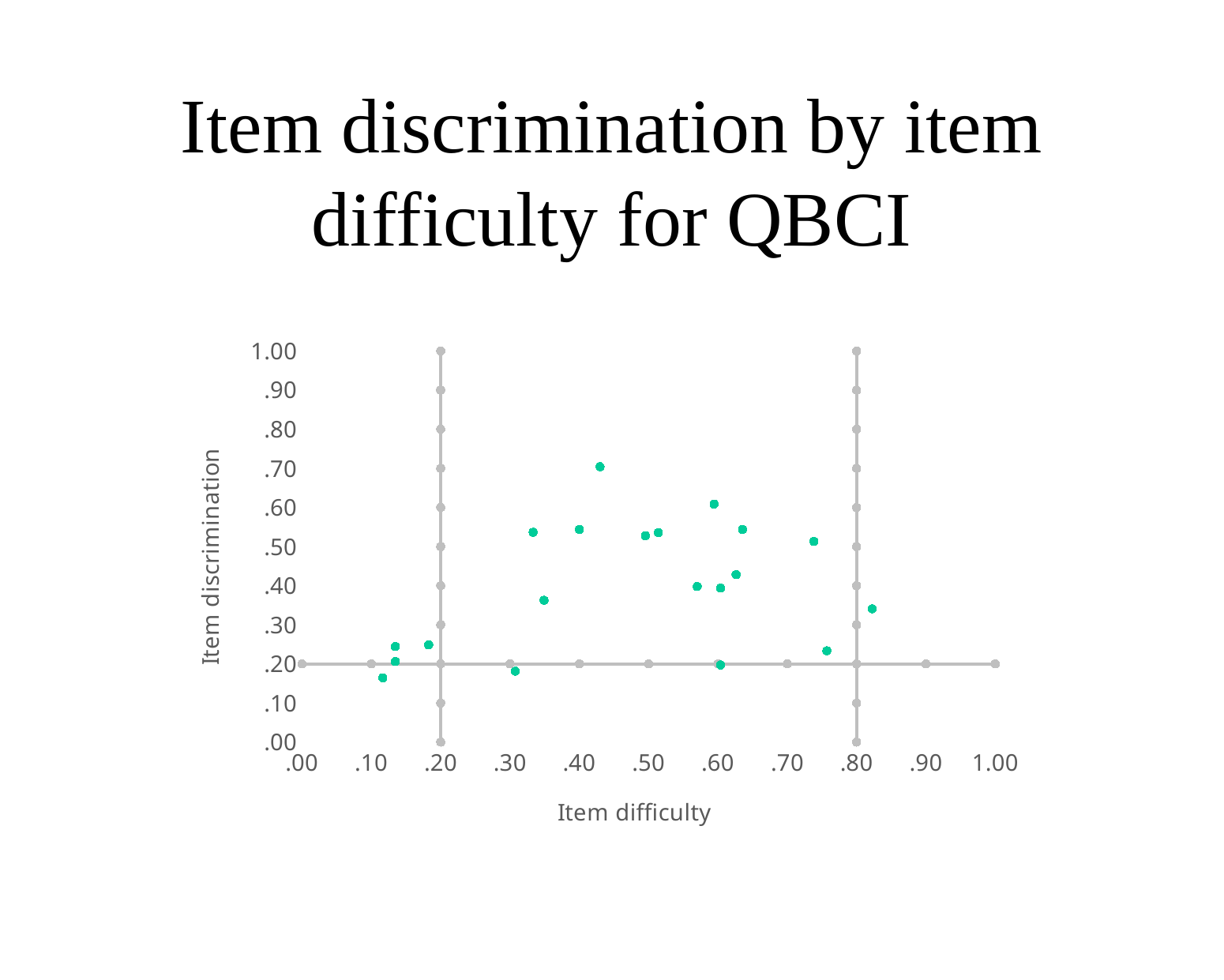
Is the item discrimination of the point with the highest item difficulty greater or less than .40? less How many data points are plotted on the chart? 20 What is the title of the chart? Item discrimination by item difficulty for QBCI Is the highest item discrimination value plotted greater or less than .80? less Is the lowest item discrimination value plotted greater or less than .20? less What is the label of the horizontal axis? Item difficulty What kind of chart is shown on the slide? Scatter plot